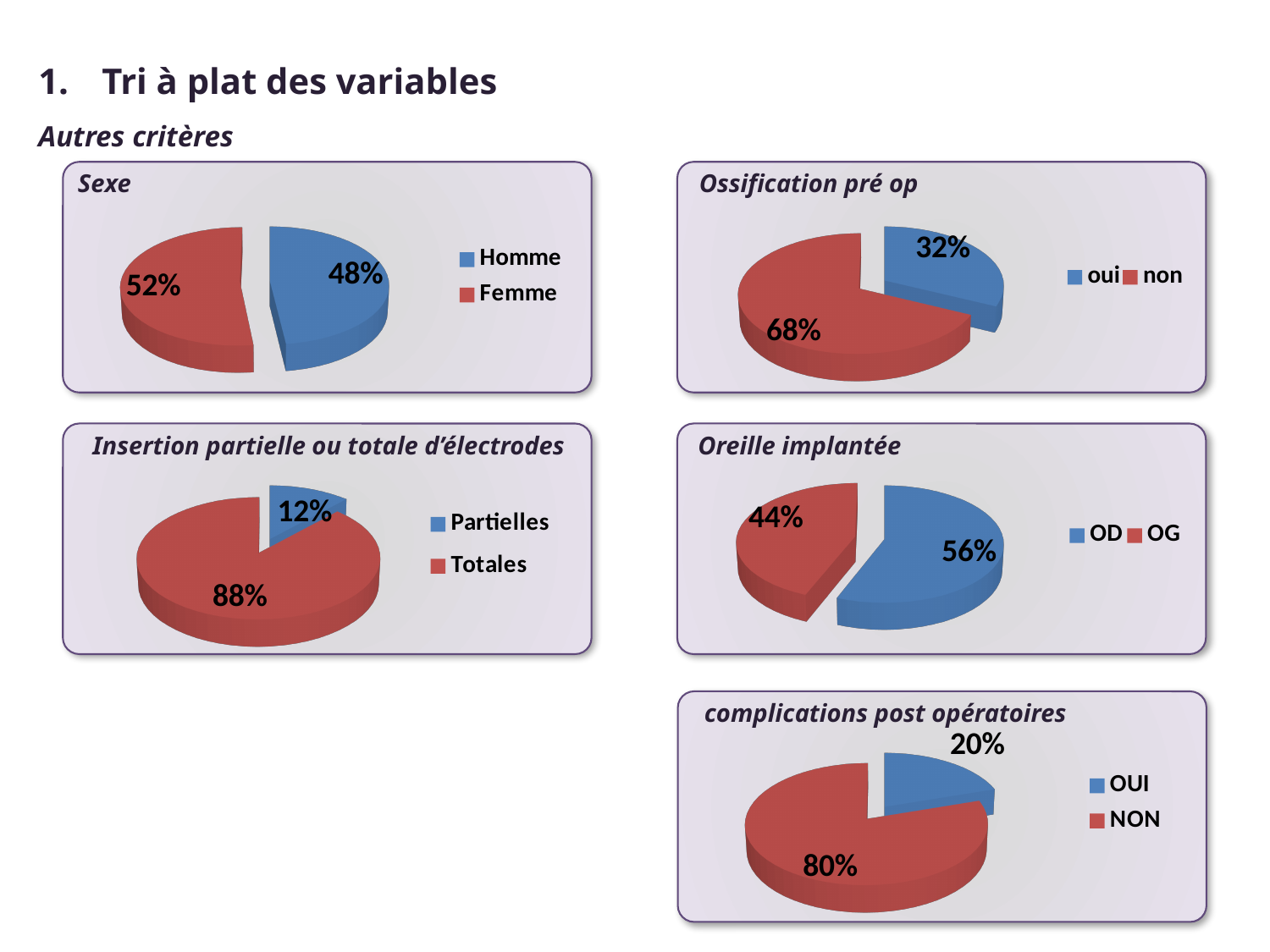
What type of chart is the 'Sexe' chart? Pie chart In the 'Ossification pré op' chart, which category is the largest? non In the 'Sexe' chart, what percentage is Homme? 48% In the 'complications post opératoires' chart, which category is the smallest? OUI In the 'Oreille implantée' chart, which is larger, OD or OG? OD In the 'complications post opératoires' chart, what percentage is OUI? 20% In the 'Sexe' chart, what percentage is Femme? 52% In the 'Oreille implantée' chart, what percentage is OG? 44% In the 'Ossification pré op' chart, what is the share for 'non'? 68% In the 'Insertion partielle ou totale d'électrodes' chart, what percentage is Partielles? 12% In the 'Insertion partielle ou totale d'électrodes' chart, what is the difference between Totales and Partielles? 76% How many categories does the legend of the 'Ossification pré op' chart list? 2